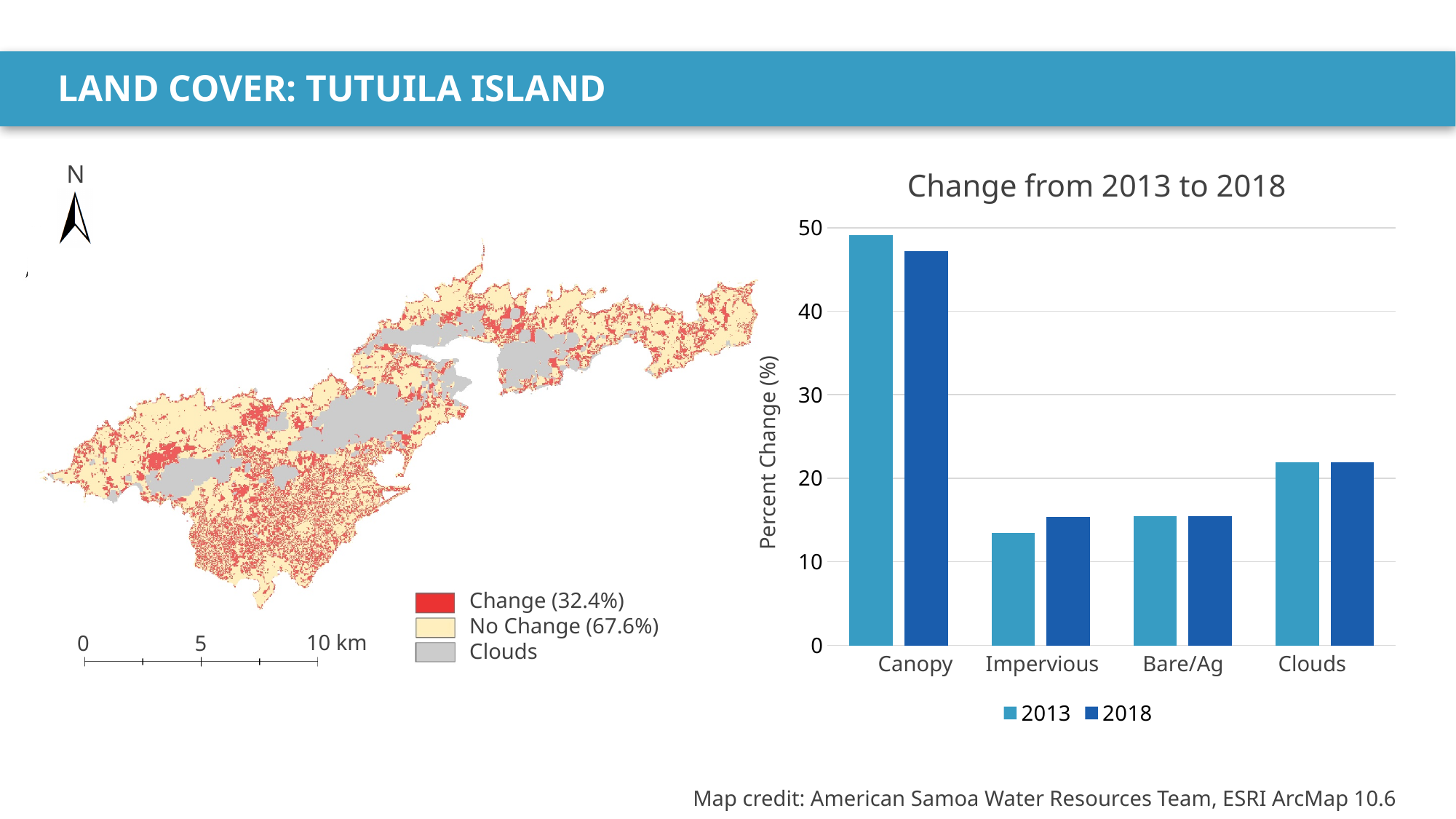
For Impervious, which is larger: the 2013 value or the 2018 value? 2018 Which category has the highest value for 2018? Canopy How many categories are shown on the x axis of the chart? 4 How many series does the chart legend list? 2 Is the 2013 value for Bare/Ag greater or less than 20? less Is the 2013 value for Canopy greater or less than 40? greater Which category has the lowest value for 2013? Impervious What kind of chart is shown on the slide? bar chart Which category has the highest value for 2013? Canopy For Canopy, which is larger: the 2013 value or the 2018 value? 2013 What is the label of the y axis of the chart? Percent Change (%) What is the title of the chart? Change from 2013 to 2018